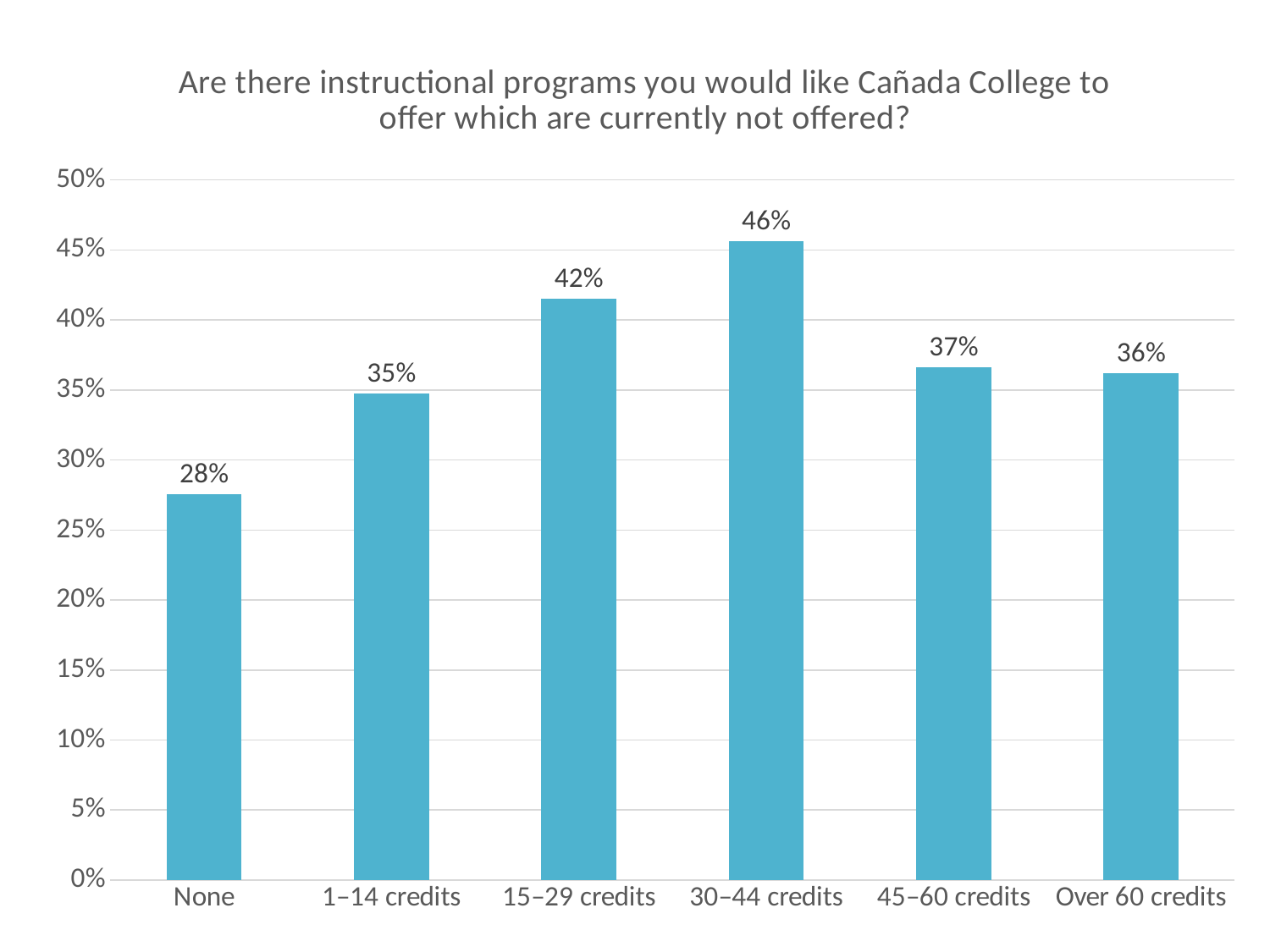
What kind of chart is shown on the slide? bar chart What is the difference between the values for 30–44 credits and None? 18% Which category has the lowest value? None What is the value for the 30–44 credits category? 46% How many categories are shown on the x axis? 6 What is the difference between the values for 15–29 credits and 1–14 credits? 7% What is the value for the None category? 28% What is the title of the chart? Are there instructional programs you would like Cañada College to offer which are currently not offered? Which category has the highest value? 30–44 credits Which is larger, the value for 15–29 credits or the value for 45–60 credits? 15–29 credits Is the value for Over 60 credits greater or less than 30%? greater What is the value for the 1–14 credits category? 35%